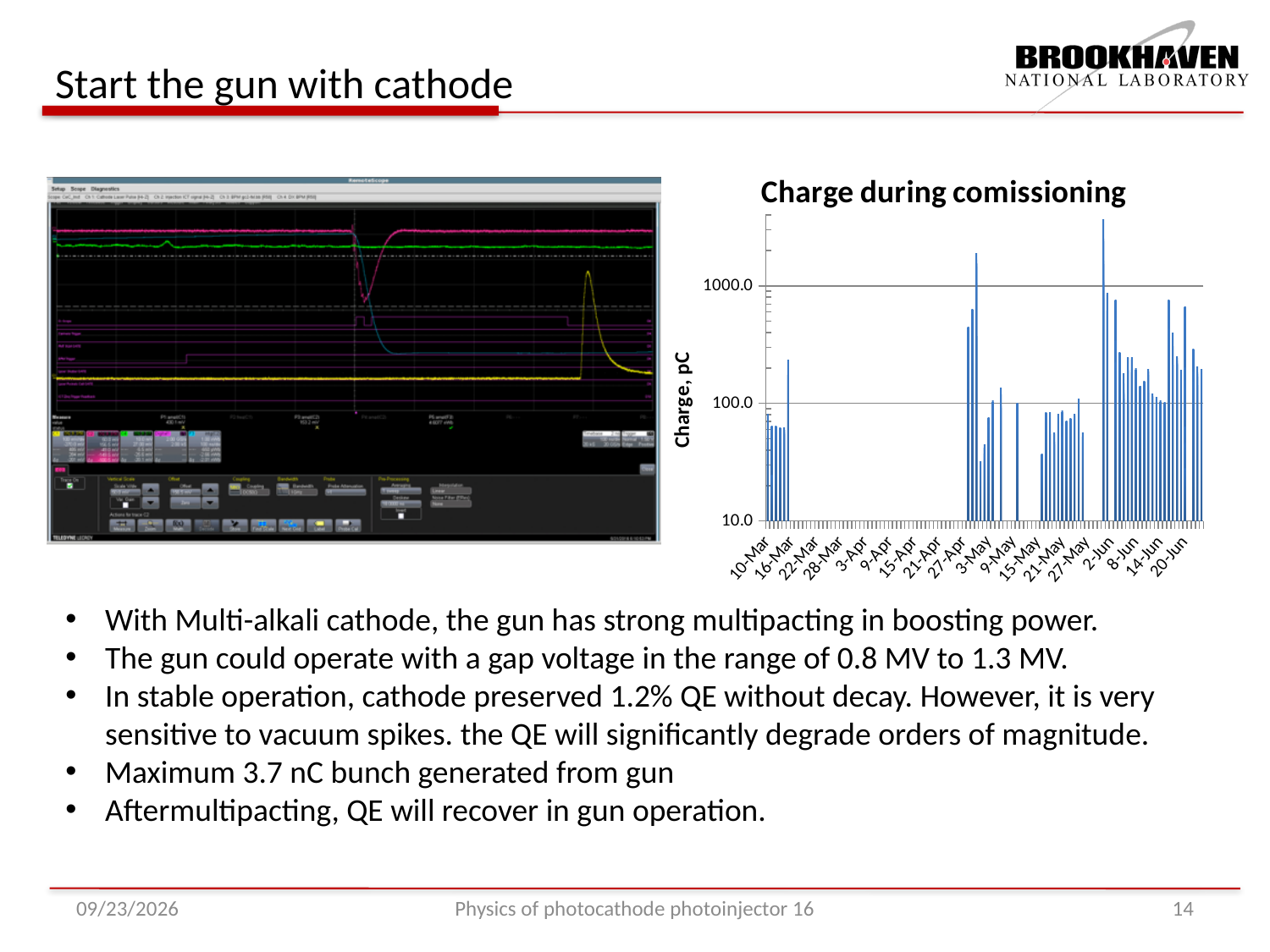
What is the last date label on the x-axis of the 'Charge during comissioning' chart? 20-Jun What is the title of the chart on the right side of the slide? Charge during comissioning In the 'Charge during comissioning' chart, is the tallest bar near 3-May greater or less than 1000.0? greater In the 'Charge during comissioning' chart, are the first bars plotted near 10-Mar greater or less than 100.0? less In the 'Charge during comissioning' chart, are the bars plotted around 21-May greater or less than 100.0? less What is the y-axis label of the 'Charge during comissioning' chart? Charge, pC In the 'Charge during comissioning' chart, which period has the taller bars: around 10-Mar or around 2-Jun? around 2-Jun How many date labels are shown on the x-axis of the 'Charge during comissioning' chart? 18 What is the first date label on the x-axis of the 'Charge during comissioning' chart? 10-Mar What is the lowest value labeled on the y-axis of the 'Charge during comissioning' chart? 10.0 What kind of chart is 'Charge during comissioning'? bar chart